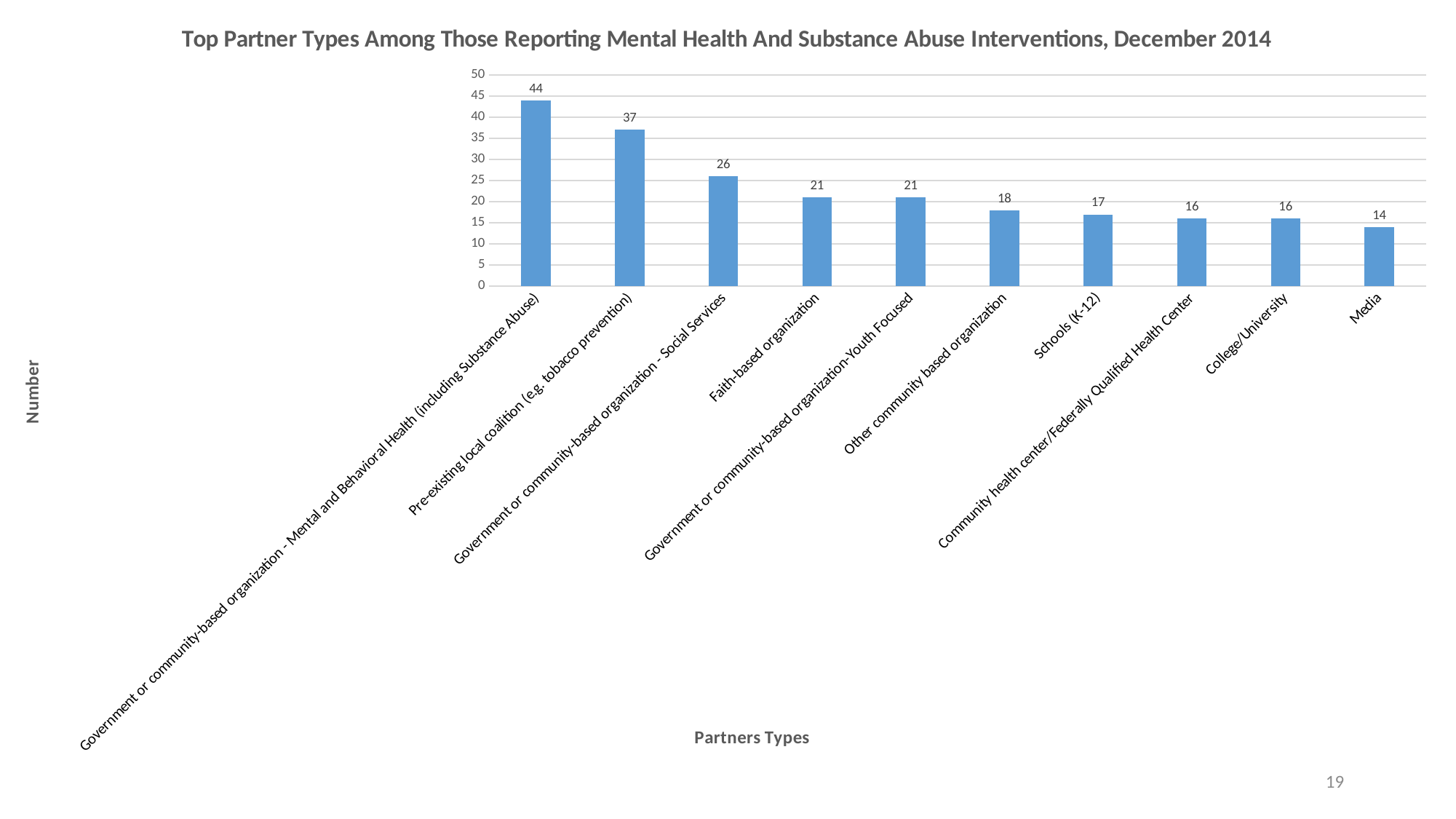
How many partner types are shown in the chart? 10 What is the difference between the values for Pre-existing local coalition (e.g. tobacco prevention) and Government or community-based organization - Social Services? 11 What is the value for Faith-based organization? 21 What is the value for Schools (K-12)? 17 What kind of chart is shown on the slide? bar chart Which is larger, the value for Other community based organization or the value for College/University? Other community based organization Which partner type has the lowest value? Media What is the value for Pre-existing local coalition (e.g. tobacco prevention)? 37 What is the value for Media? 14 Is the value for Community health center/Federally Qualified Health Center greater or less than 20? less What is the label of the x axis? Partners Types Which partner type has the highest value? Government or community-based organization - Mental and Behavioral Health (including Substance Abuse)